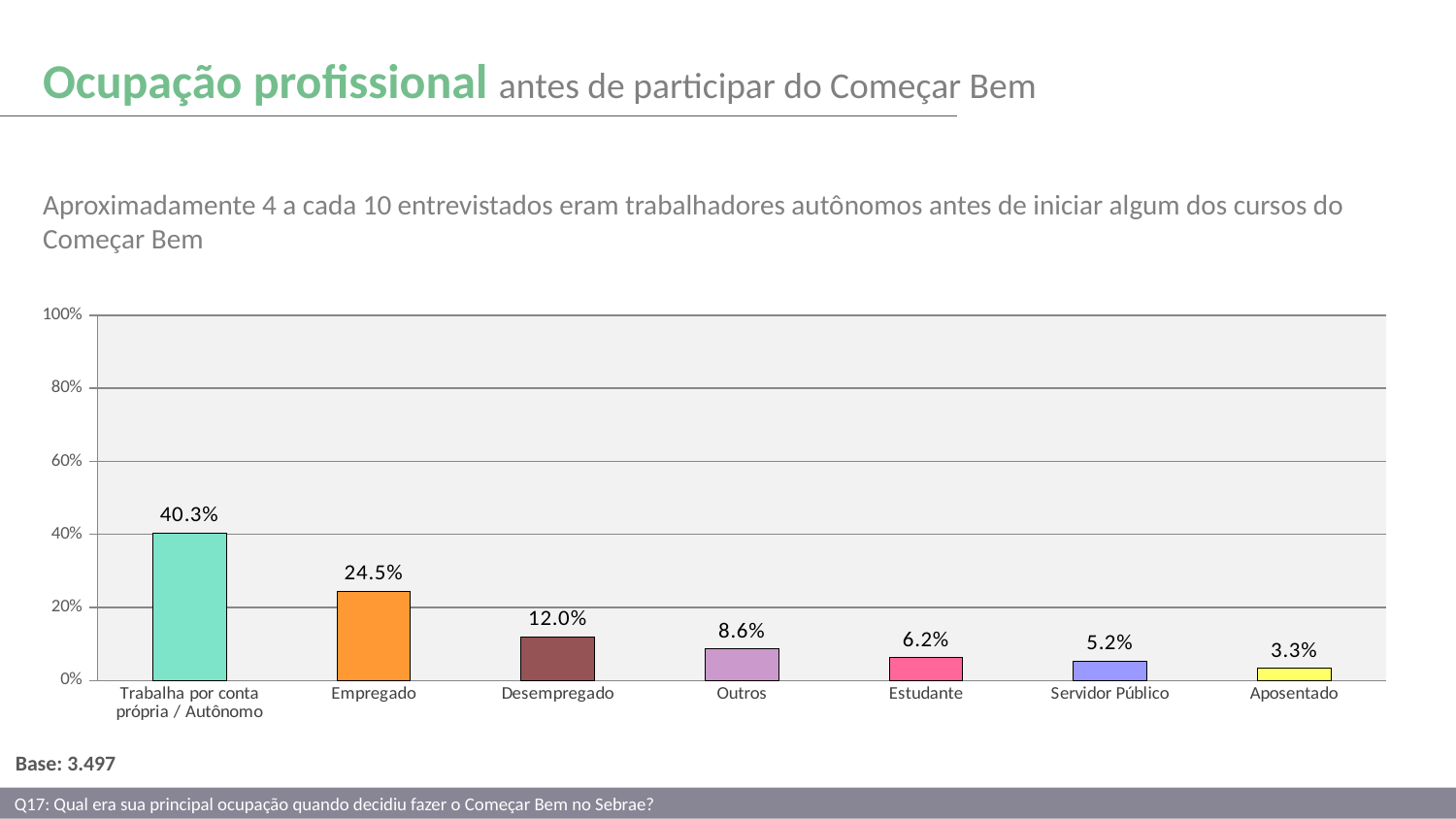
How many categories are shown on the x axis? 7 What is the value for Desempregado? 12.0% What is the value for Empregado? 24.5% Which is larger, the value for Outros or the value for Estudante? Outros Which category has the highest value? Trabalha por conta própria / Autônomo Is the value for Trabalha por conta própria / Autônomo greater or less than 40%? greater What is the difference between the values for Trabalha por conta própria / Autônomo and Empregado? 15.8% What is the value for Servidor Público? 5.2% Which category has the lowest value? Aposentado What kind of chart is shown on the slide? bar chart Do the values rise or fall from left to right along the x axis? fall What is the base (number of respondents) stated below the chart? 3.497